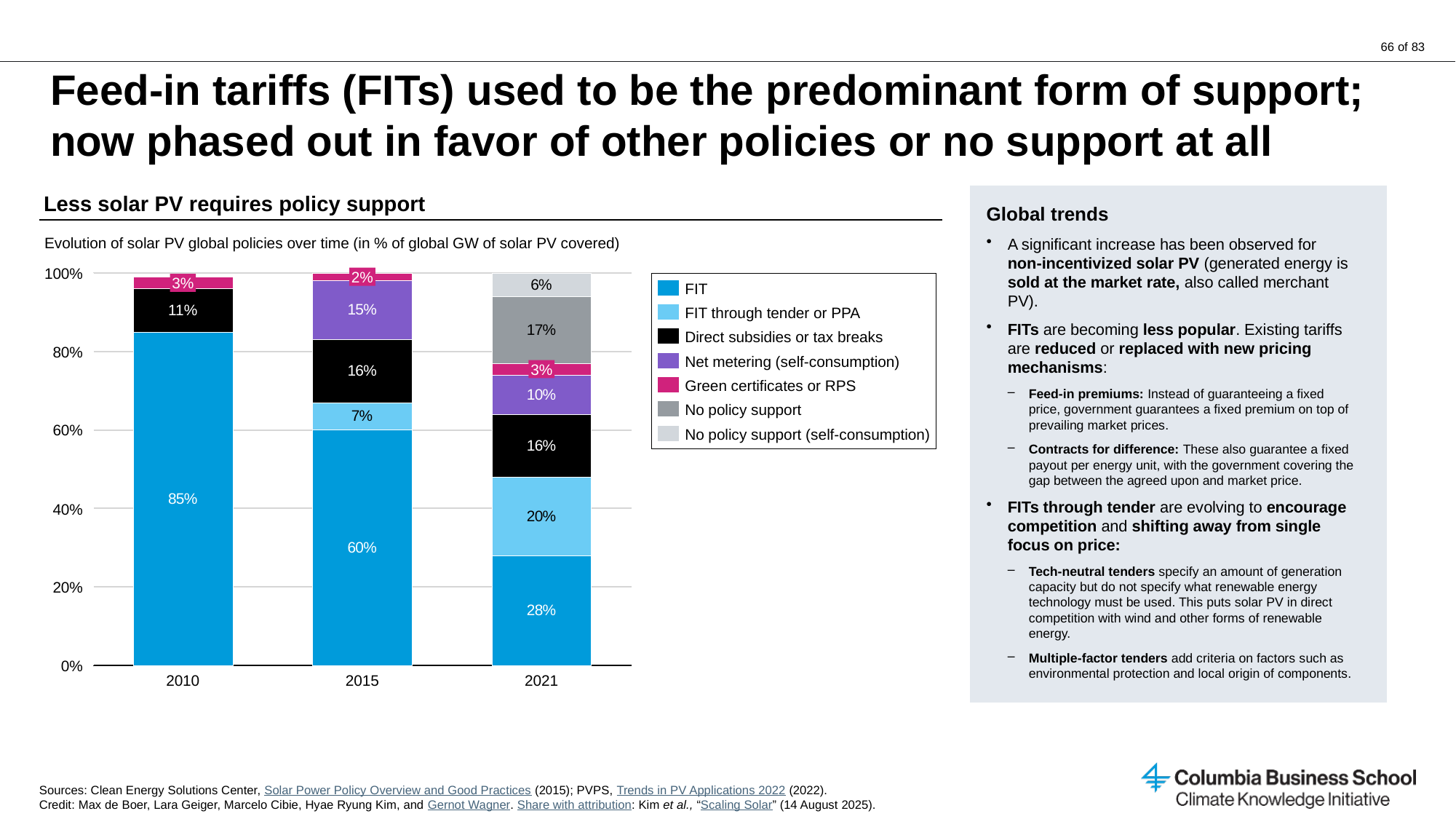
Which is larger in 2021: the share for Direct subsidies or tax breaks or the share for Net metering (self-consumption)? Direct subsidies or tax breaks How many years are shown on the x axis of the chart? 3 What type of chart is shown on the slide? Stacked bar chart What share of global solar PV GW was covered by FIT in 2010? 85% How does the FIT share change across the years from 2010 to 2021? It falls By how many percentage points did the FIT share fall from 2010 to 2021? 57 percentage points What is the total of the 2021 stacked bar? 100% In which year was the FIT share the lowest? 2021 What share was covered by No policy support in 2021? 17% How many series does the chart's legend list? 7 What share was covered by Net metering (self-consumption) in 2015? 15% What share was covered by FIT through tender or PPA in 2021? 20%